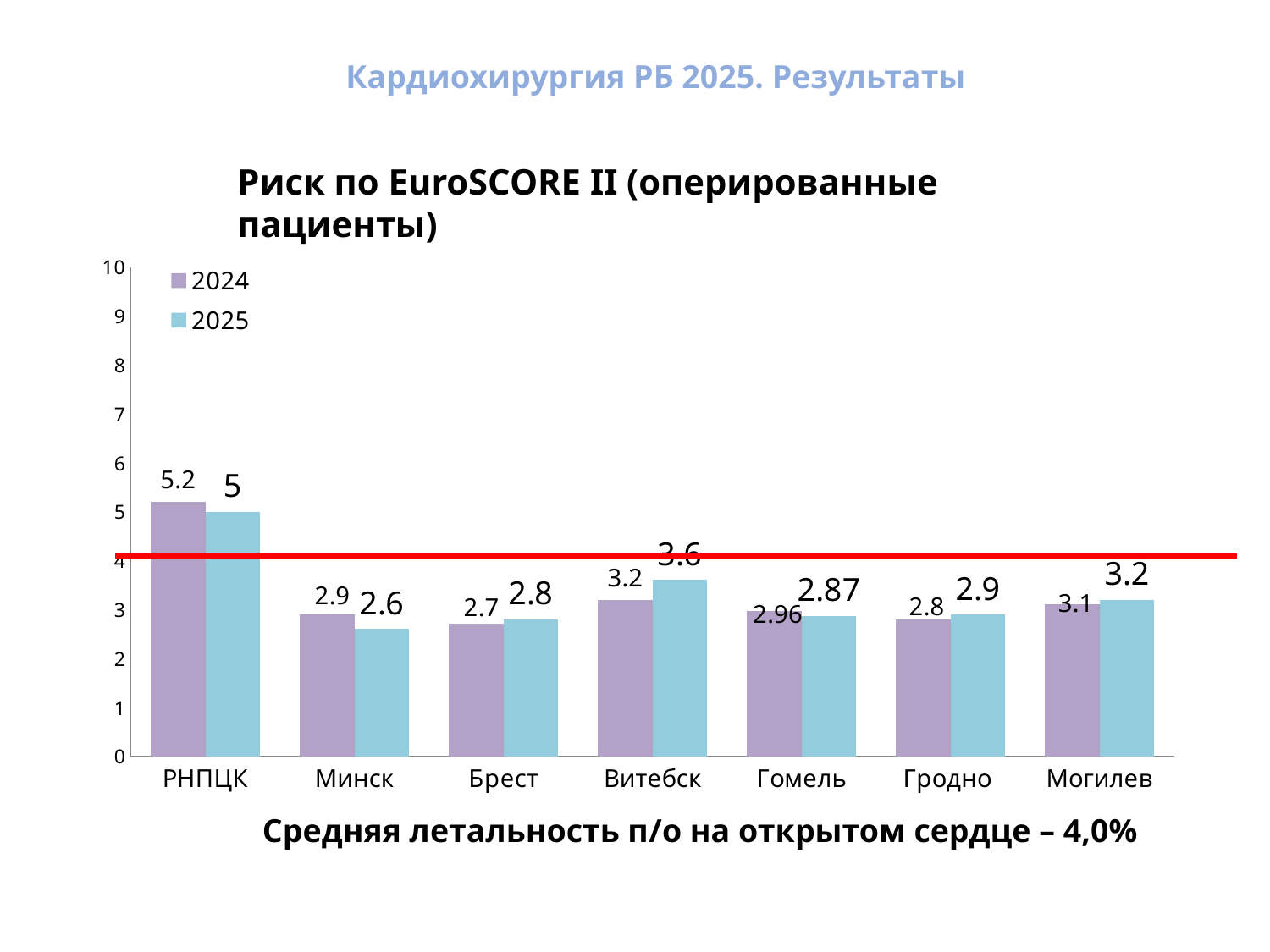
How many categories are shown on the x axis? 7 Is the 2024 value for РНПЦК greater or less than 4? greater What is the 2025 value for Витебск? 3.6 Which category has the highest 2025 value? РНПЦК What is the difference between the 2024 and 2025 values for РНПЦК? 0.2 How many series does the legend list? 2 What is the 2024 value for РНПЦК? 5.2 What kind of chart is shown? bar chart What is the 2025 value for Минск? 2.6 Which category has the lowest 2025 value? Минск What is the 2024 value for Гомель? 2.96 Which is larger for Витебск, the 2024 value or the 2025 value? 2025